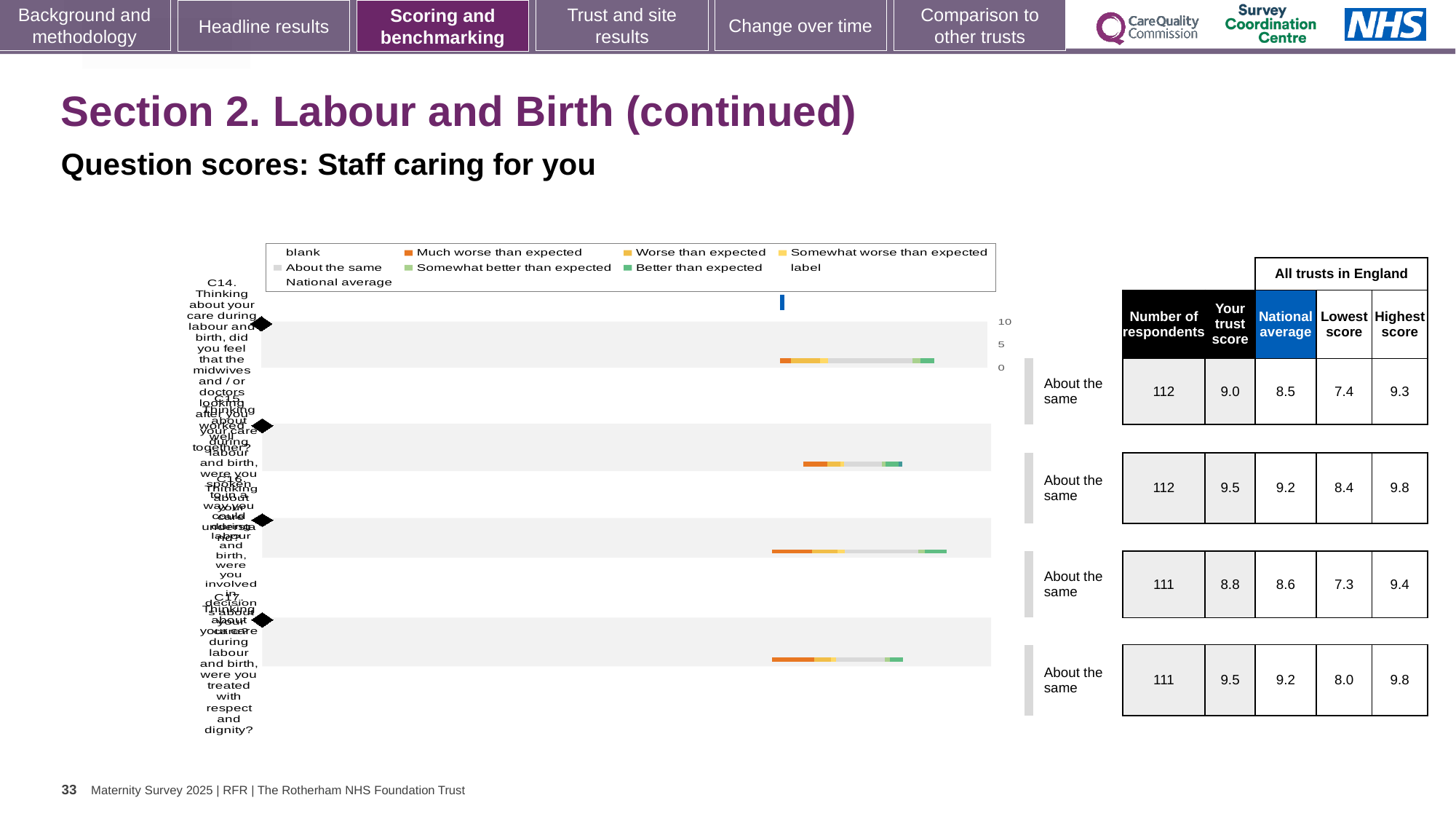
Is the trust score for question C14 greater or less than 5? greater What benchmark label is shown for question C17 (treated with respect and dignity)? About the same What is the trust score for question C17 (were you treated with respect and dignity)? 9.5 What is the difference between the trust score and the national average for question C17 (treated with respect and dignity)? 0.3 What is the national average score for question C14 (midwives and/or doctors worked well together)? 8.5 What is the difference between the highest score and the lowest score across all trusts for question C14? 1.9 Which is larger for question C14: the trust score or the national average? trust score What kind of chart is shown on the slide? bar chart What colour does the legend use for 'Much worse than expected'? orange What is the trust score for question C14 (did the midwives and/or doctors looking after you work well together)? 9.0 How many entries does the chart legend list? 9 How many questions (rows) are plotted in the chart? 4